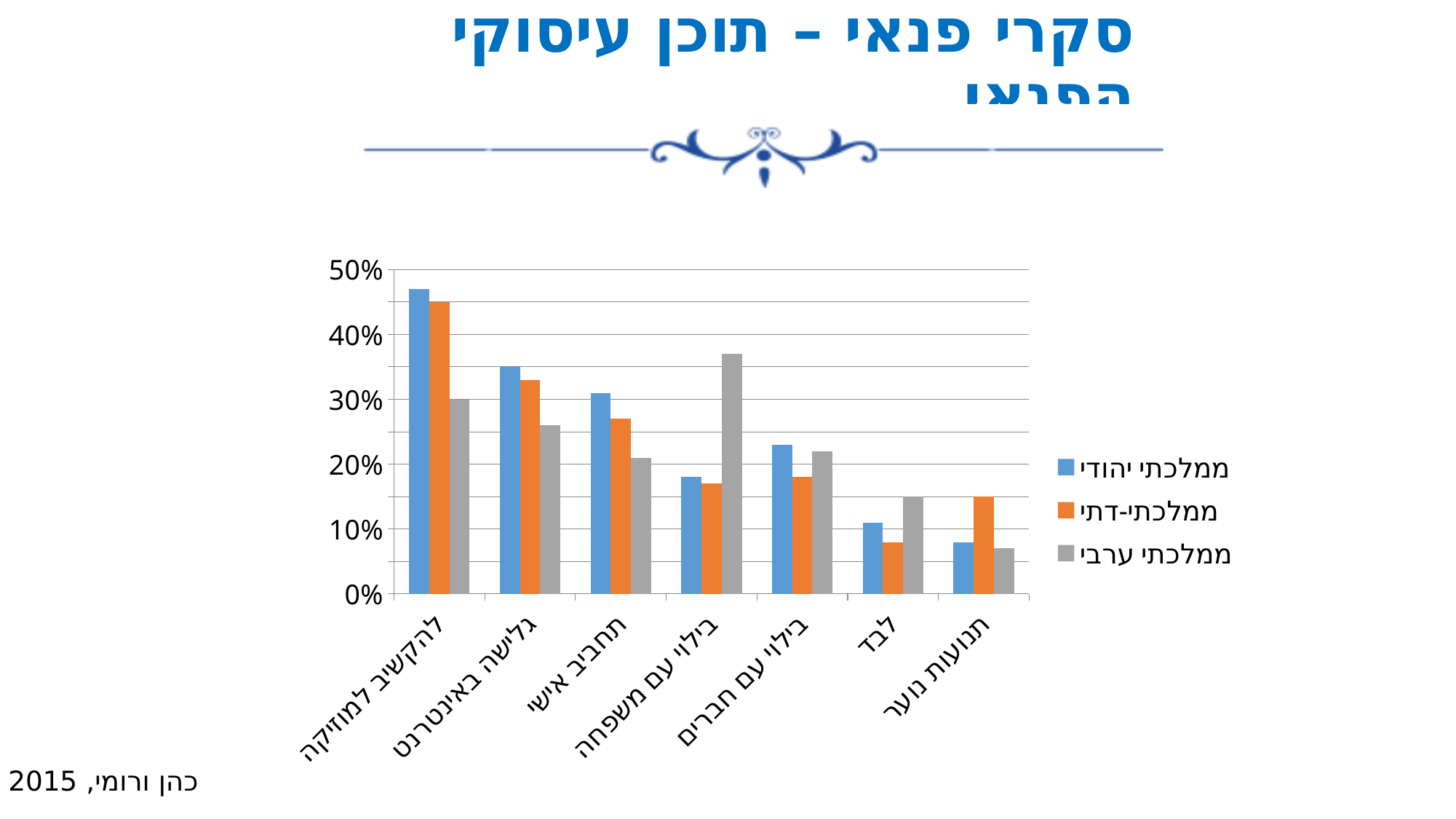
Is the value for ממלכתי ערבי in the category תנועות נוער greater or less than 10%? less For the series ממלכתי יהודי, which category has the highest value? להקשיב למוזיקה Is the value for ממלכתי יהודי in the category להקשיב למוזיקה greater or less than 40%? greater What kind of chart is shown on the slide? bar chart In the category בילוי עם משפחה, which series has the larger value: ממלכתי יהודי or ממלכתי ערבי? ממלכתי ערבי For the series ממלכתי-דתי, which category has the lowest value? לבד How many categories are shown on the x axis of the chart? 7 For the series ממלכתי ערבי, which category has the highest value? בילוי עם משפחה In the category תנועות נוער, which series has the larger value: ממלכתי יהודי or ממלכתי-דתי? ממלכתי-דתי For the series ממלכתי יהודי, which category has the lowest value? תנועות נוער What colour represents the series ממלכתי ערבי in the chart? gray How many series does the chart's legend list? 3